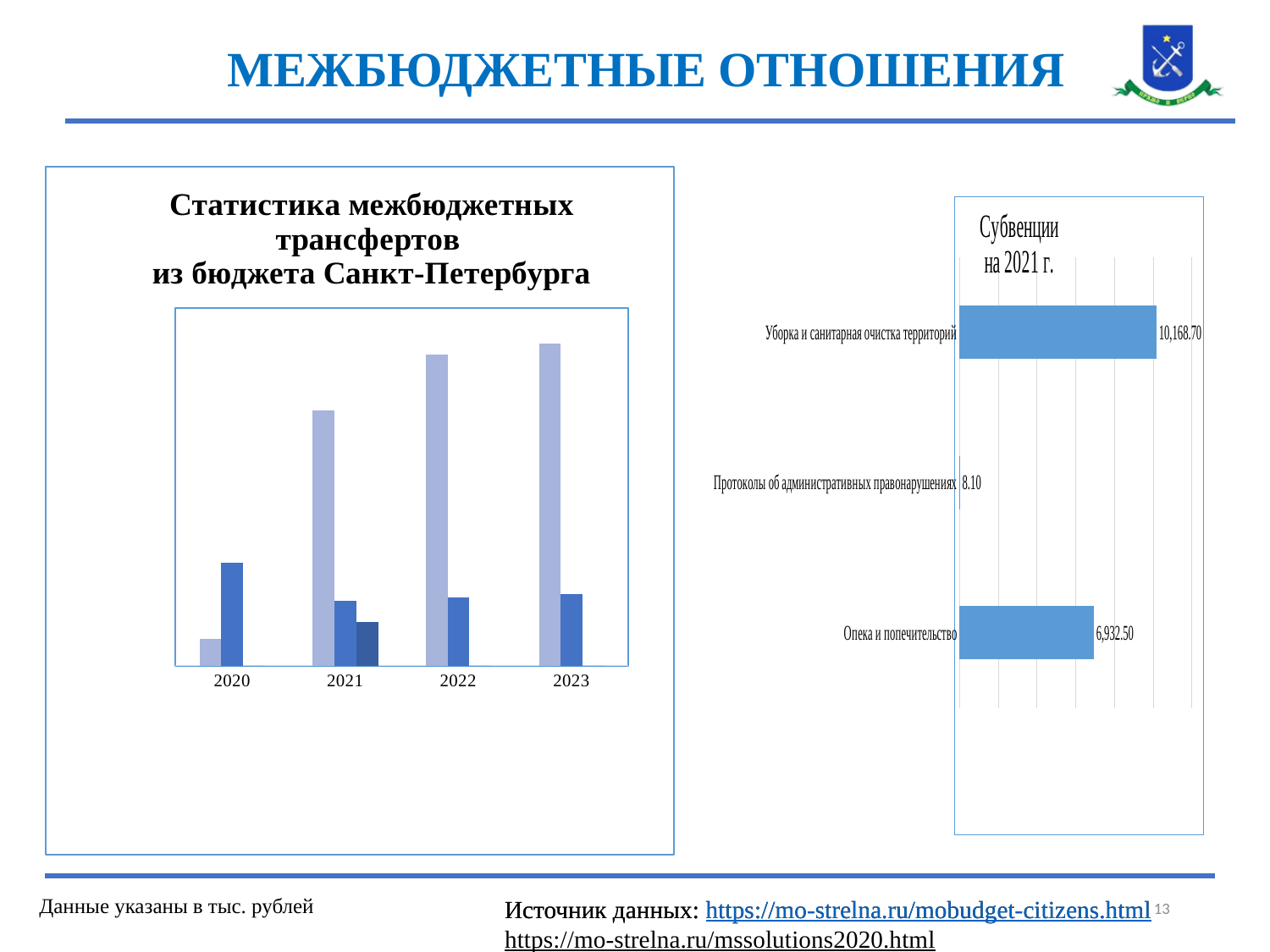
In the chart 'Субвенции на 2021 г.', what is the value for 'Уборка и санитарная очистка территорий'? 10,168.70 In the chart 'Субвенции на 2021 г.', which category has the highest value? Уборка и санитарная очистка территорий What kind of chart is 'Субвенции на 2021 г.'? Bar chart In the chart 'Субвенции на 2021 г.', which category has the lowest value? Протоколы об административных правонарушениях In the chart 'Субвенции на 2021 г.', how many categories are shown? 3 In the chart 'Субвенции на 2021 г.', what is the value for 'Опека и попечительство'? 6,932.50 What kind of chart is 'Статистика межбюджетных трансфертов из бюджета Санкт-Петербурга'? Bar chart In the chart 'Субвенции на 2021 г.', what is the difference between the values for 'Уборка и санитарная очистка территорий' and 'Опека и попечительство'? 3,236.20 In the chart 'Субвенции на 2021 г.', which is larger: 'Опека и попечительство' or 'Протоколы об административных правонарушениях'? Опека и попечительство In the chart 'Статистика межбюджетных трансфертов из бюджета Санкт-Петербурга', do the tallest bars rise or fall from 2020 to 2023? Rise In the chart 'Статистика межбюджетных трансфертов из бюджета Санкт-Петербурга', how many years are shown on the x axis? 4 In the chart 'Субвенции на 2021 г.', what is the value for 'Протоколы об административных правонарушениях'? 8.10